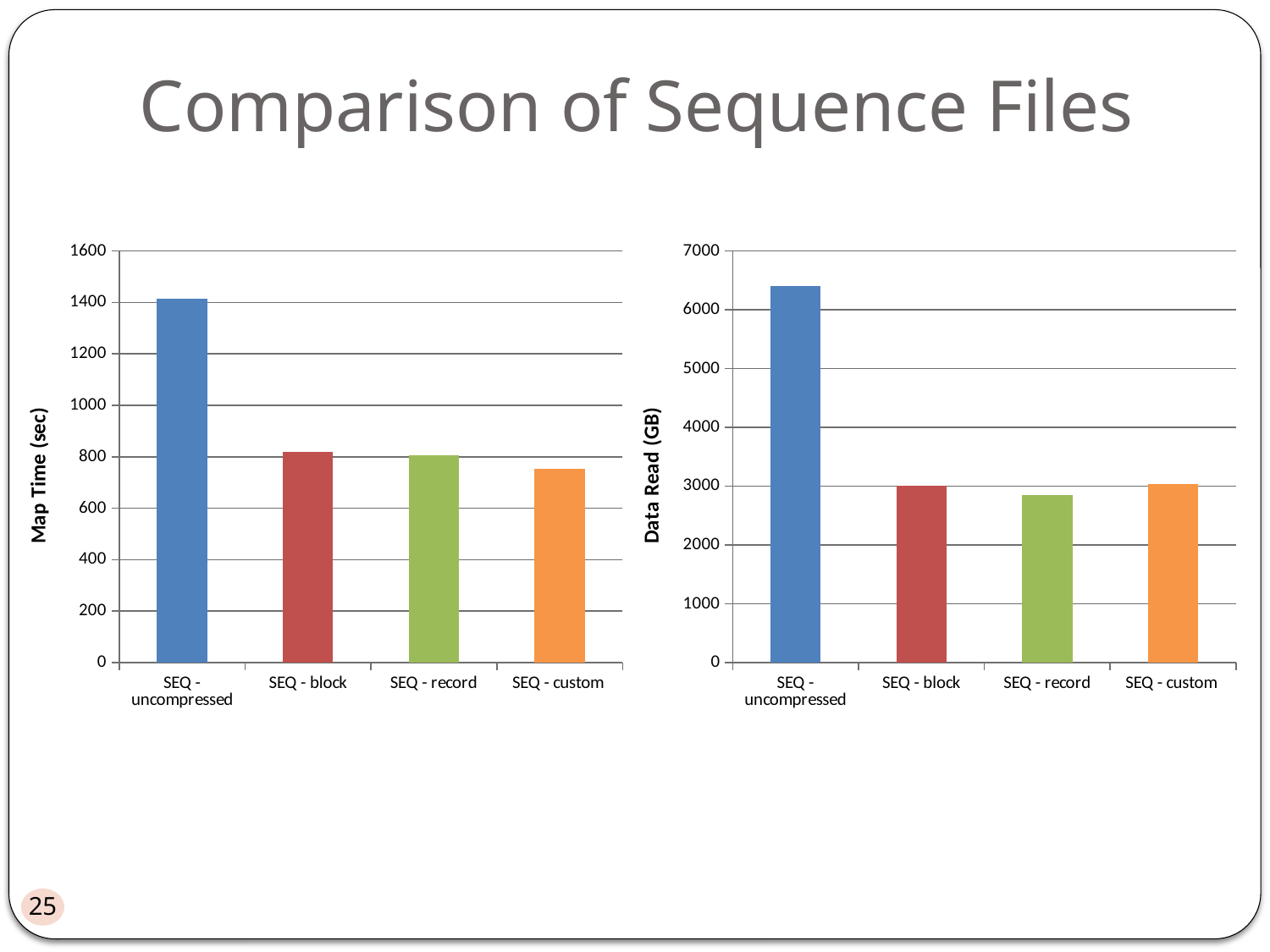
On the right chart (Data Read), is the value for SEQ - block greater or less than 4000? less What kind of chart is the right chart (Data Read)? bar chart How many categories are shown on the left chart (Map Time)? 4 On the right chart (Data Read), is the value for SEQ - uncompressed greater or less than 6000? greater What is the y-axis label of the right chart? Data Read (GB) On the right chart (Data Read), which category has the highest value? SEQ - uncompressed On the left chart (Map Time), which category has the lowest value? SEQ - custom On the left chart (Map Time), is the value for SEQ - custom greater or less than 800? less On the left chart (Map Time), which category has the highest value? SEQ - uncompressed On the right chart (Data Read), which is larger, SEQ - uncompressed or SEQ - record? SEQ - uncompressed